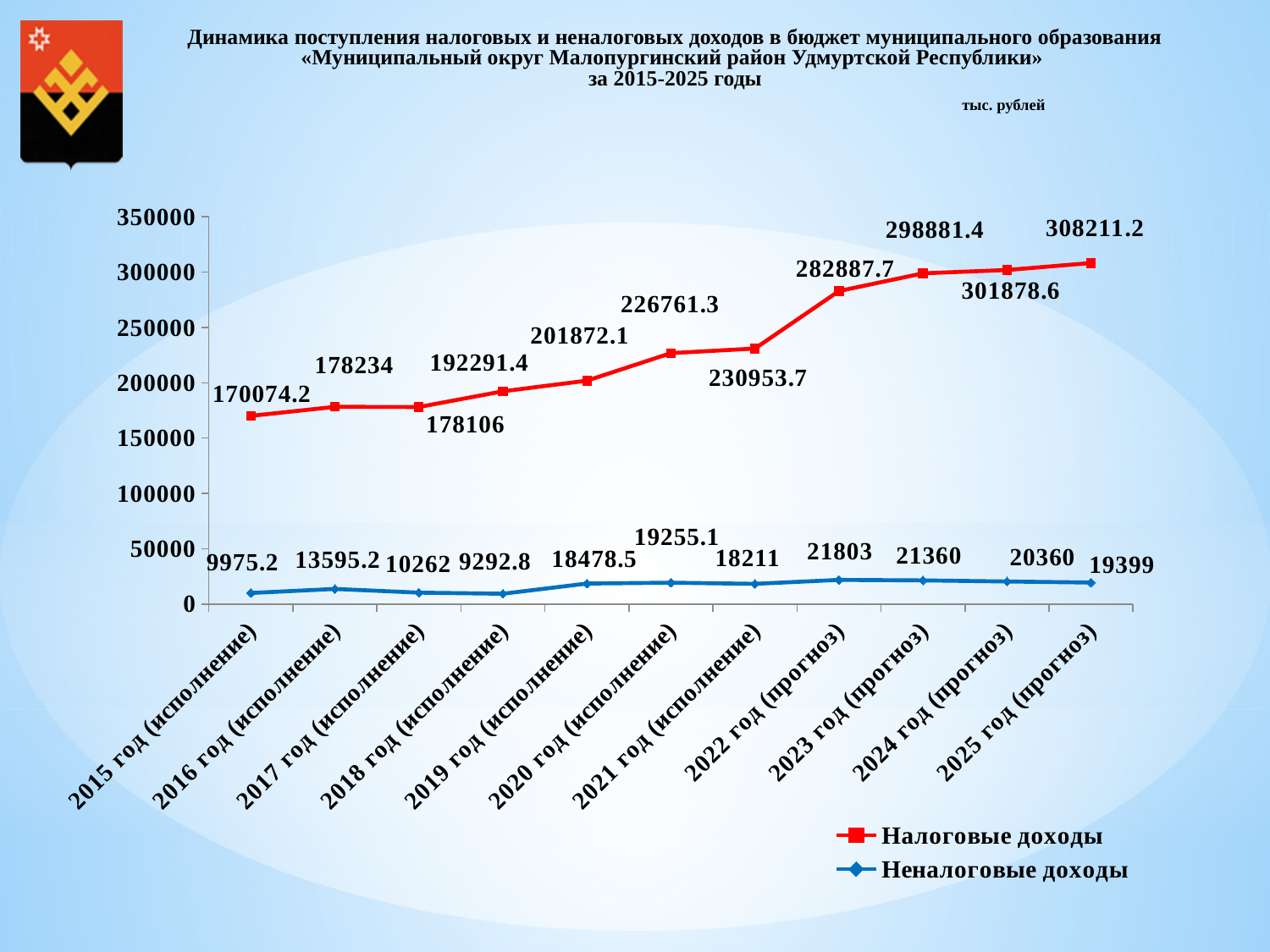
What is the difference between Неналоговые доходы in 2022 год (прогноз) and 2018 год (исполнение)? 12510.2 What is the difference between Налоговые доходы in 2025 год (прогноз) and 2015 год (исполнение)? 138137 What is the value of Налоговые доходы for 2015 год (исполнение)? 170074.2 Is the value of Налоговые доходы for 2022 год (прогноз) greater or less than 250000? greater In which year is Налоговые доходы highest? 2025 год (прогноз) What is the value of Налоговые доходы for 2020 год (исполнение)? 226761.3 What is the value of Неналоговые доходы for 2022 год (прогноз)? 21803 In which year is Неналоговые доходы lowest? 2018 год (исполнение) Which is larger: Налоговые доходы in 2016 год (исполнение) or in 2017 год (исполнение)? 2016 год (исполнение) What kind of chart is shown on the slide? line chart How many series does the legend list? 2 How many years are shown on the x axis? 11